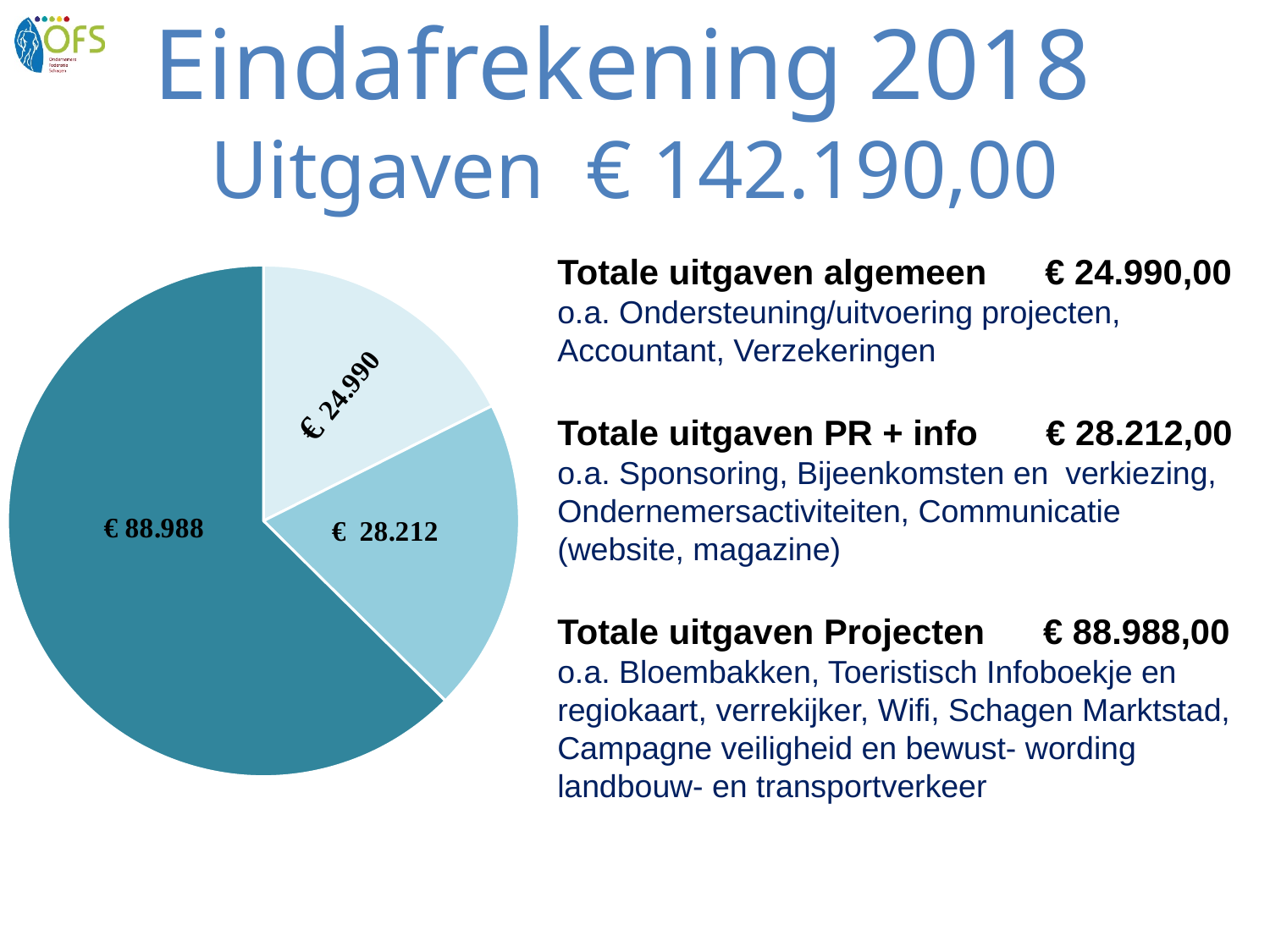
What value is printed on the medium blue slice on the right side of the pie chart? € 28.212 What colour is the largest slice of the pie chart? dark teal Does the € 88.988 slice make up more or less than half of the pie? more How many slices does the pie chart have? 3 What kind of chart is shown on the slide? pie chart What is the difference between the € 28.212 slice and the € 24.990 slice? € 3.222 What is the difference between the € 88.988 slice and the € 28.212 slice? € 60.776 What is the total of the three slices in the pie chart? € 142.190 What is the value of the smallest slice of the pie chart? € 24.990 What is the value of the largest slice of the pie chart? € 88.988 Which slice is larger: the one labelled € 28.212 or the one labelled € 24.990? € 28.212 What value is printed on the light blue slice at the top right of the pie chart? € 24.990